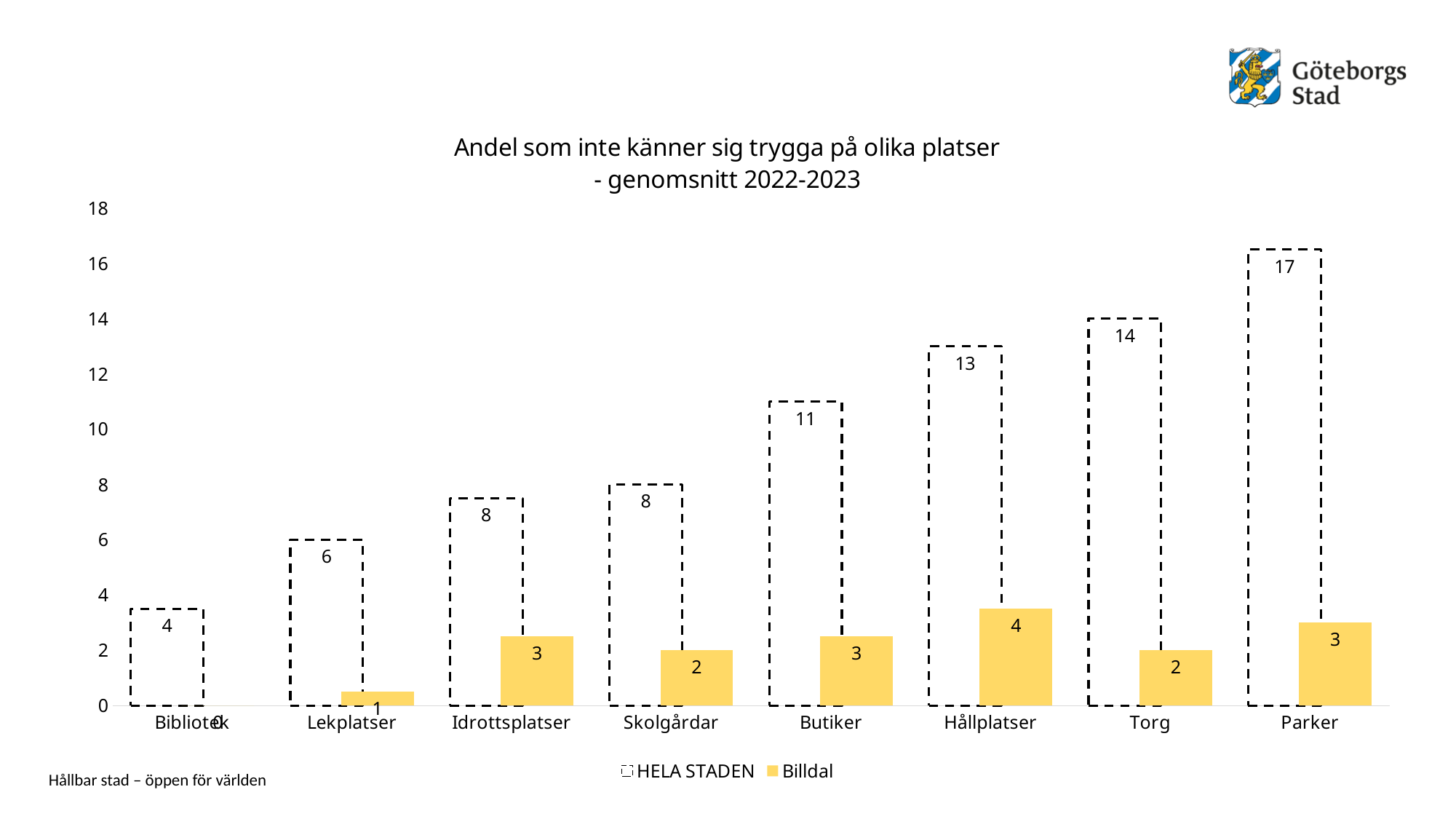
Which category has the lowest value for HELA STADEN? Bibliotek How many series does the legend list? 2 What is the difference between HELA STADEN and Billdal at Torg? 12 Which category has the highest value for Billdal? Hållplatser Which category has the highest value for HELA STADEN? Parker What is the value for HELA STADEN at Parker? 17 How many categories are shown on the x axis? 8 What is the value for HELA STADEN at Butiker? 11 Which is larger at Skolgårdar: HELA STADEN or Billdal? HELA STADEN What is the value for Billdal at Lekplatser? 1 What kind of chart is shown on the slide? Bar chart What is the value for Billdal at Hållplatser? 4